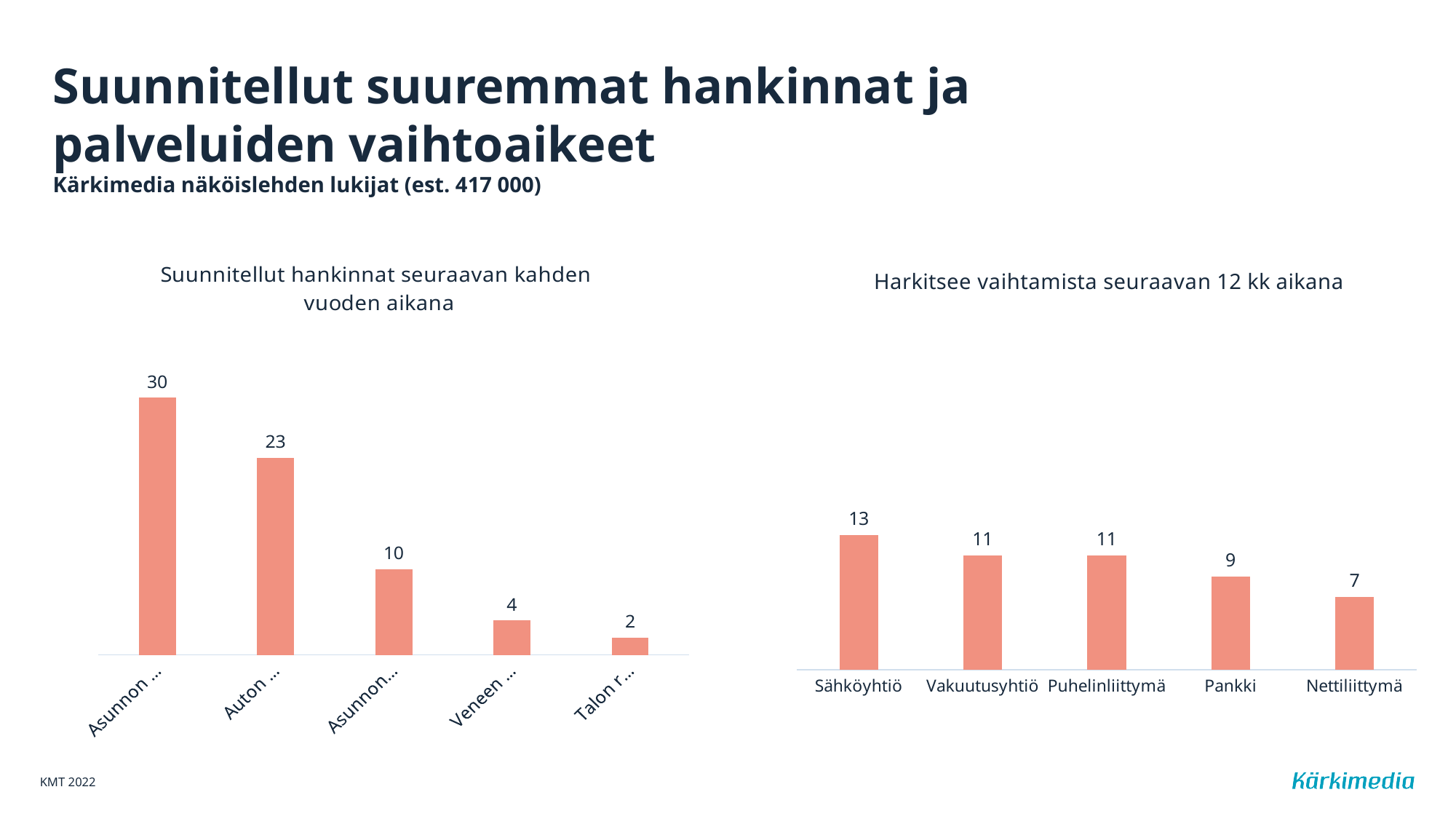
In the chart titled "Suunnitellut hankinnat seuraavan kahden vuoden aikana", do the values rise or fall from left to right? fall In the chart titled "Harkitsee vaihtamista seuraavan 12 kk aikana", what is the value for Pankki? 9 In the chart titled "Suunnitellut hankinnat seuraavan kahden vuoden aikana", what is the value for the category labelled "Veneen ..."? 4 In the chart titled "Suunnitellut hankinnat seuraavan kahden vuoden aikana", what is the value of the first (leftmost) bar? 30 In the chart titled "Harkitsee vaihtamista seuraavan 12 kk aikana", what is the difference between the values for Sähköyhtiö and Nettiliittymä? 6 What kind of chart is the chart titled "Suunnitellut hankinnat seuraavan kahden vuoden aikana"? bar chart In the chart titled "Harkitsee vaihtamista seuraavan 12 kk aikana", which category has the lowest value? Nettiliittymä In the chart titled "Harkitsee vaihtamista seuraavan 12 kk aikana", is the value for Vakuutusyhtiö larger or smaller than the value for Pankki? larger In the chart titled "Harkitsee vaihtamista seuraavan 12 kk aikana", what is the value for Sähköyhtiö? 13 In the chart titled "Harkitsee vaihtamista seuraavan 12 kk aikana", how many categories are shown? 5 In the chart titled "Suunnitellut hankinnat seuraavan kahden vuoden aikana", what is the value for the category labelled "Auton ..."? 23 In the chart titled "Harkitsee vaihtamista seuraavan 12 kk aikana", which category has the highest value? Sähköyhtiö